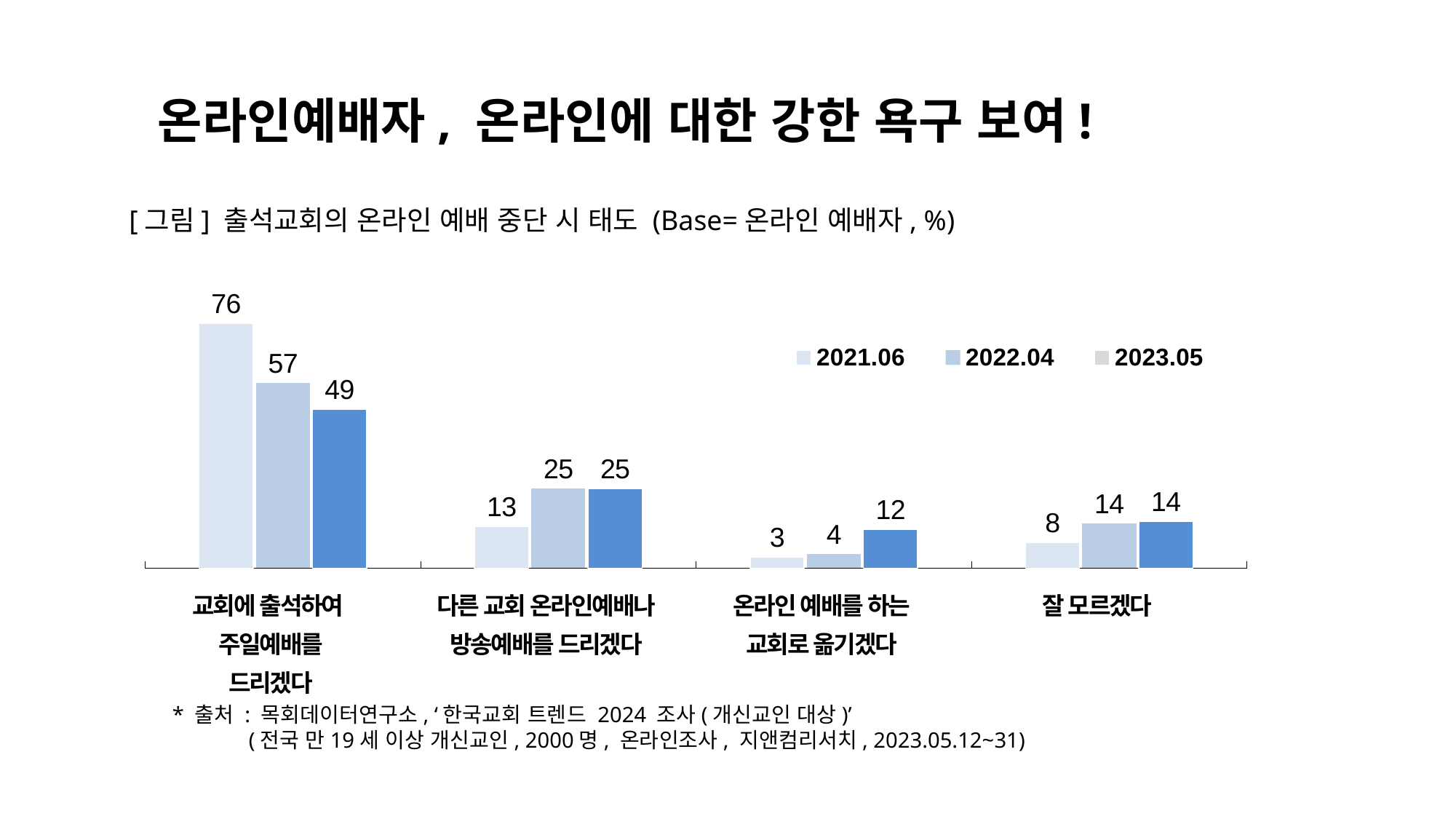
What is the difference between the 2021.06 and 2023.05 values for 교회에 출석하여 주일예배를 드리겠다? 27 Which is larger for 온라인 예배를 하는 교회로 옮기겠다: the 2022.04 value or the 2023.05 value? 2023.05 What is the 2021.06 value for 교회에 출석하여 주일예배를 드리겠다? 76 What kind of chart is shown on the slide? bar chart Does the value for 교회에 출석하여 주일예배를 드리겠다 rise or fall from 2021.06 to 2023.05? fall How many series does the legend list? 3 What is the 2023.05 value for 온라인 예배를 하는 교회로 옮기겠다? 12 Which category has the highest 2023.05 value? 교회에 출석하여 주일예배를 드리겠다 How many categories are shown on the x axis? 4 What is the 2021.06 value for 다른 교회 온라인예배나 방송예배를 드리겠다? 13 Which category has the lowest 2021.06 value? 온라인 예배를 하는 교회로 옮기겠다 What is the 2022.04 value for 잘 모르겠다? 14